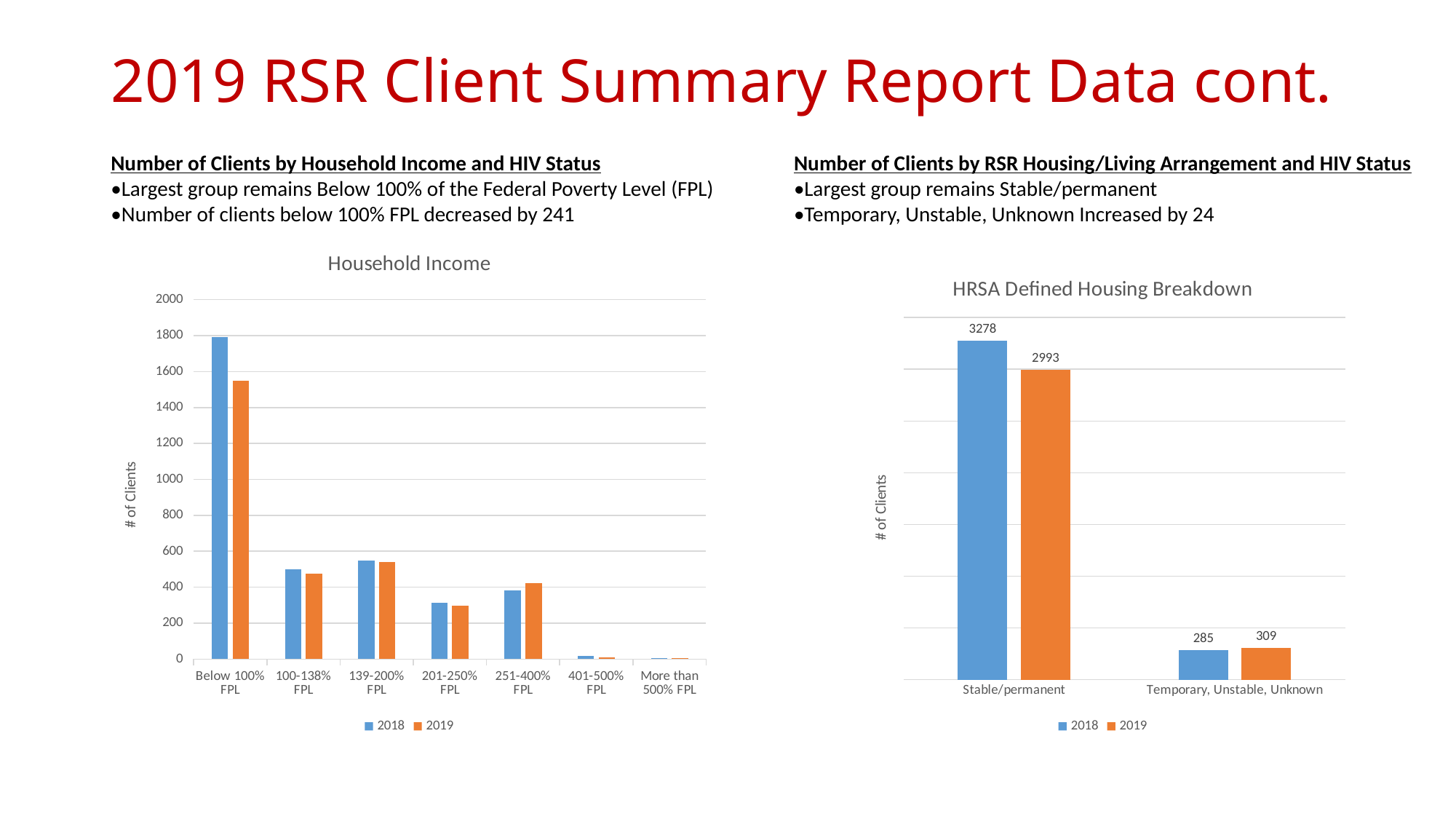
In the HRSA Defined Housing Breakdown chart, by how much did Stable/permanent decrease from 2018 to 2019? 285 What type of chart is the Household Income chart? Bar chart In the Household Income chart, for 251-400% FPL, which year has the larger value, 2018 or 2019? 2019 In the HRSA Defined Housing Breakdown chart, what is the value for Stable/permanent in 2019? 2993 In the HRSA Defined Housing Breakdown chart, what is the value for Stable/permanent in 2018? 3278 In the Household Income chart, which category has the highest value for 2018? Below 100% FPL In the Household Income chart, is the 2019 value for 139-200% FPL greater or less than 400? greater In the HRSA Defined Housing Breakdown chart, what is the value for Temporary, Unstable, Unknown in 2019? 309 How many income categories are shown on the x axis of the Household Income chart? 7 In the HRSA Defined Housing Breakdown chart, what is the difference between the 2019 and 2018 values for Temporary, Unstable, Unknown? 24 In the HRSA Defined Housing Breakdown chart, which category has the highest 2018 value? Stable/permanent In the Household Income chart, is the 2018 value for Below 100% FPL greater or less than 1600? greater